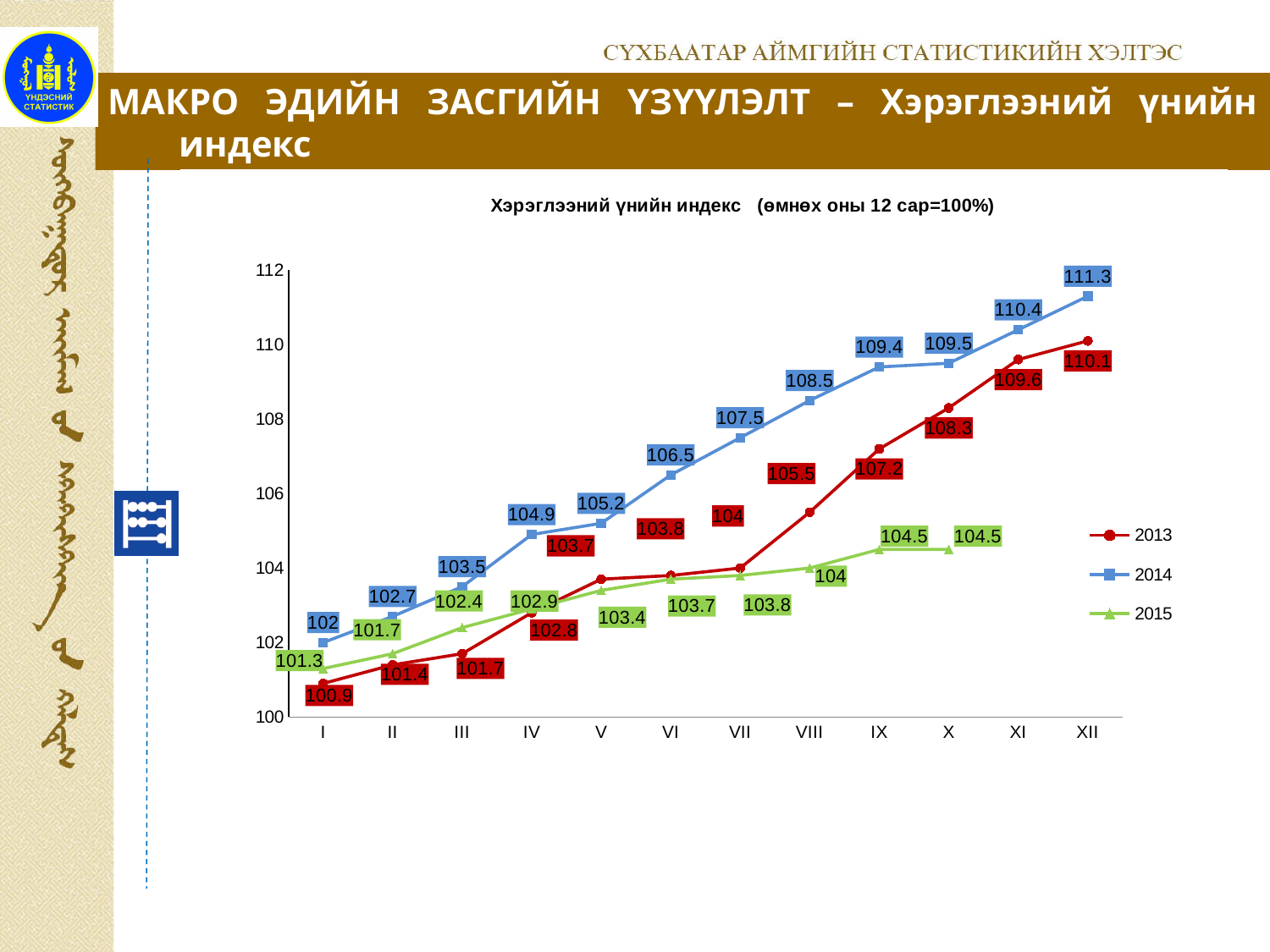
Which is larger in month IX, the 2014 value or the 2013 value? 2014 What is the title of the chart? Хэрэглээний үнийн индекс (өмнөх оны 12 сар=100%) What is the value for 2013 in month I? 100.9 What type of chart is shown on the slide? line chart What is the difference between the 2014 and 2013 values in month XII? 1.2 In which month is the 2014 series at its highest? XII In which month is the 2013 series at its lowest? I What is the value for 2015 in month VIII? 104 What is the value for 2014 in month XII? 111.3 How many months are shown on the x axis? 12 Does the 2014 series rise or fall from month I to month XII? rise How many series does the legend list? 3